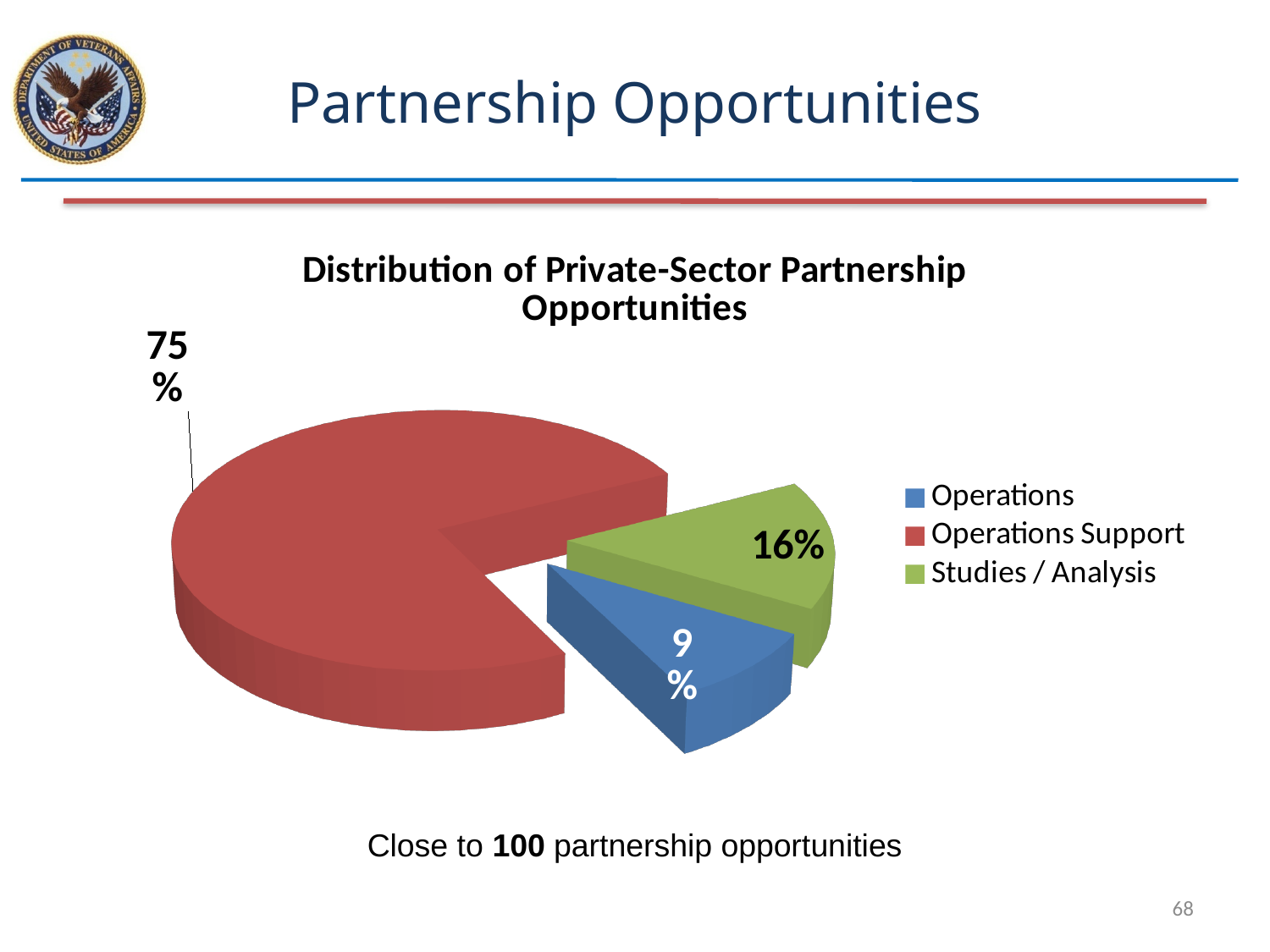
Which is larger, the share for Studies / Analysis or the share for Operations? Studies / Analysis What share of the pie does Studies / Analysis represent? 16% What colour is the Operations Support slice? Red What kind of chart is shown on the slide? Pie chart What is the difference in percentage points between Studies / Analysis and Operations? 7 What share of the pie does Operations represent? 9% What share of the pie does Operations Support represent? 75% What is the difference in percentage points between Operations Support and Studies / Analysis? 59 How many categories does the legend list? 3 What is the title of the chart? Distribution of Private-Sector Partnership Opportunities Which category has the largest slice of the pie? Operations Support Which category has the smallest slice of the pie? Operations